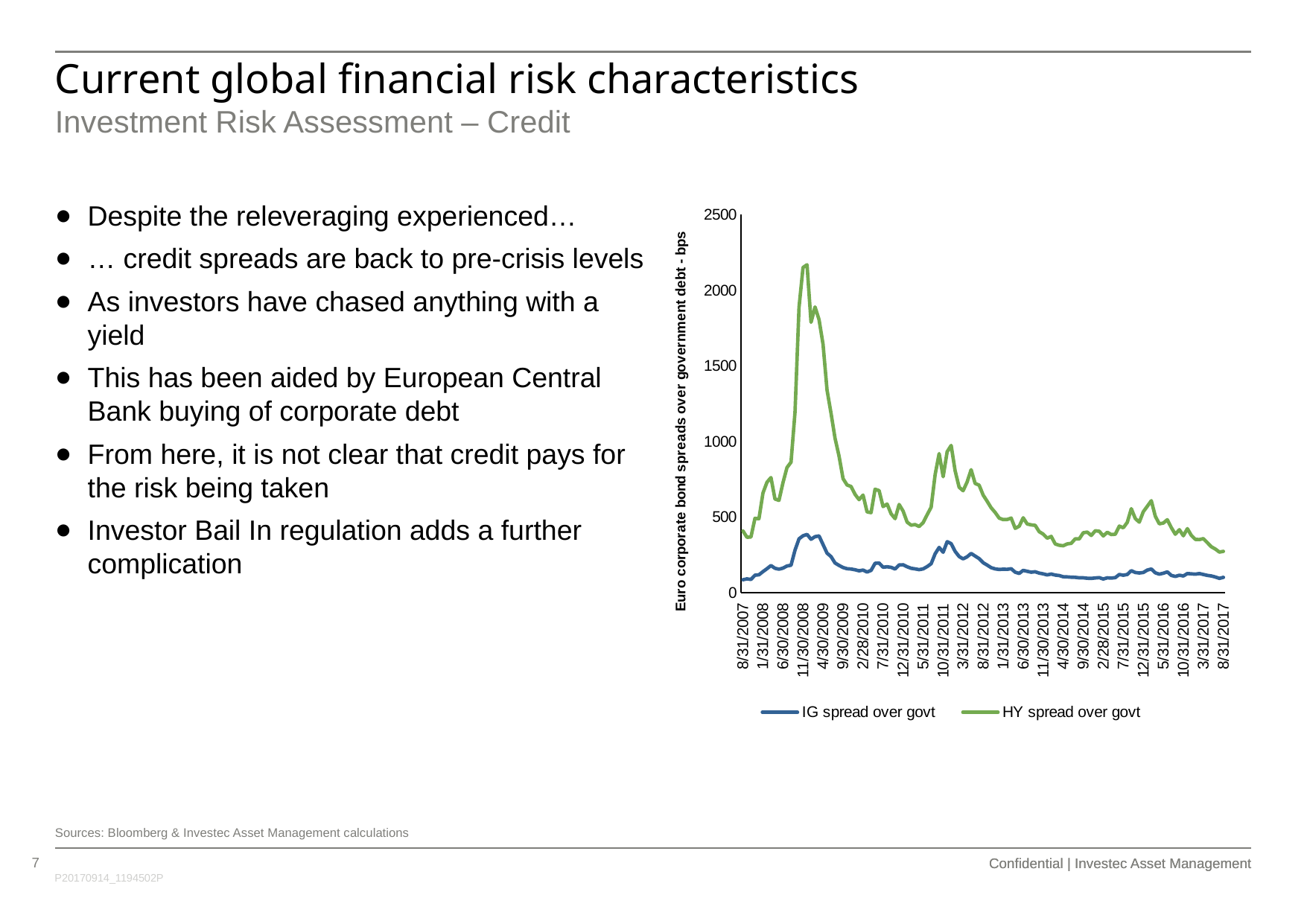
Is the peak value of the IG spread over govt series around 11/30/2008 greater or less than 500? less At 8/31/2017, which series has the larger value, IG spread over govt or HY spread over govt? HY spread over govt Is the peak value of the HY spread over govt series around 11/30/2008 greater or less than 2000? greater What are the two series named in the chart's legend? IG spread over govt and HY spread over govt What is the label on the chart's vertical axis? Euro corporate bond spreads over government debt - bps Does the HY spread over govt series rise or fall between 12/31/2015 and 8/31/2017? Fall What is the highest value shown on the chart's vertical axis? 2500 How many series does the chart's legend list? 2 What kind of chart is shown on the slide? Line chart Is the value of the HY spread over govt series around 10/31/2011 greater or less than 500? greater Which series reaches the higher peak value, IG spread over govt or HY spread over govt? HY spread over govt